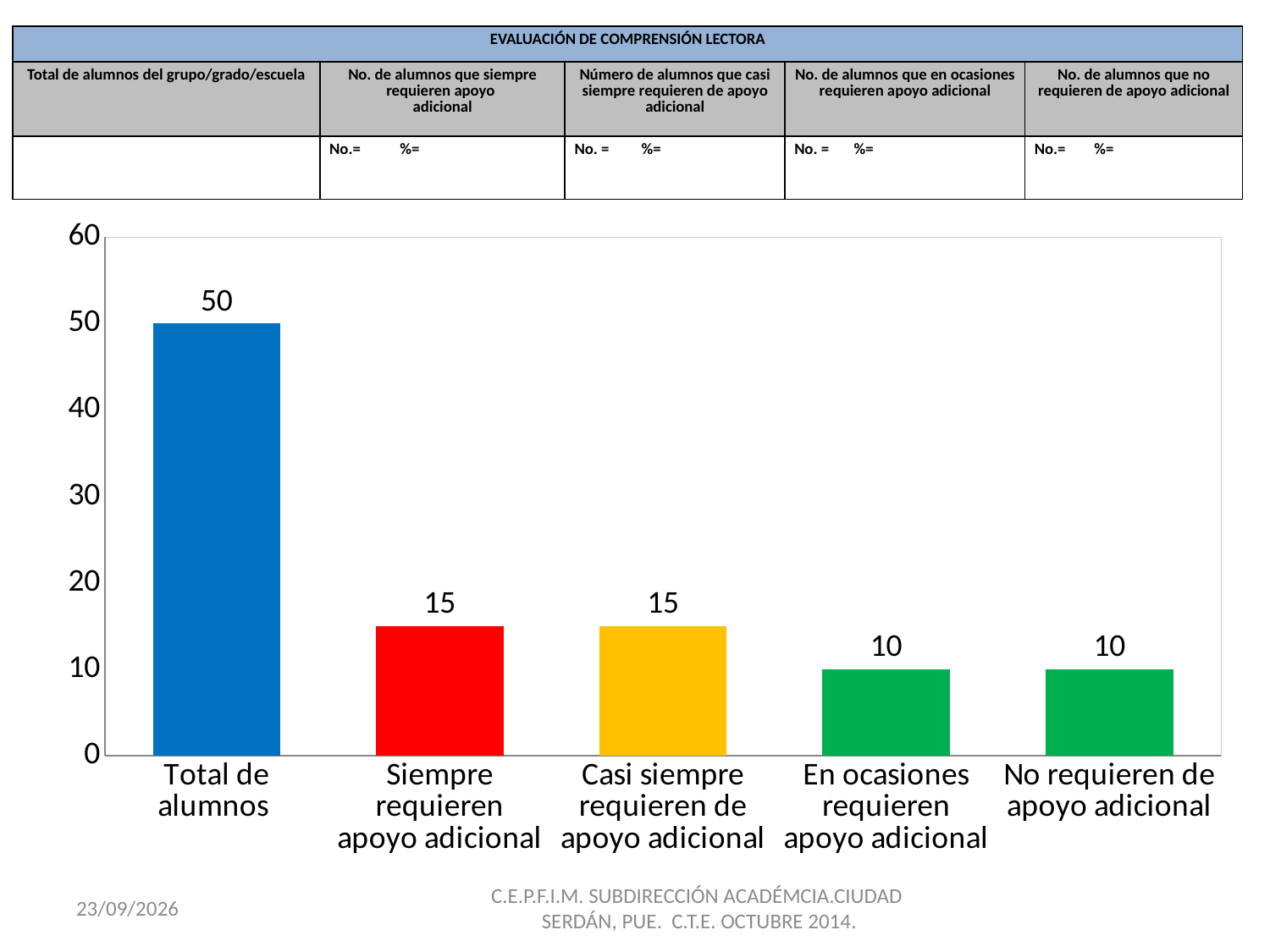
How many categories are shown on the chart? 5 Is the value for "Total de alumnos" greater or less than 40? greater What is the value for "Siempre requieren apoyo adicional"? 15 What colour is the bar for "Total de alumnos"? blue What is the value for "En ocasiones requieren apoyo adicional"? 10 What kind of chart is shown on the slide? bar chart What is the value for "No requieren de apoyo adicional"? 10 Which is larger, the value for "Casi siempre requieren de apoyo adicional" or the value for "No requieren de apoyo adicional"? Casi siempre requieren de apoyo adicional What is the difference between the values for "Siempre requieren apoyo adicional" and "En ocasiones requieren apoyo adicional"? 5 Which category has the highest value? Total de alumnos What is the value for "Total de alumnos"? 50 What is the difference between the values for "Total de alumnos" and "Casi siempre requieren de apoyo adicional"? 35